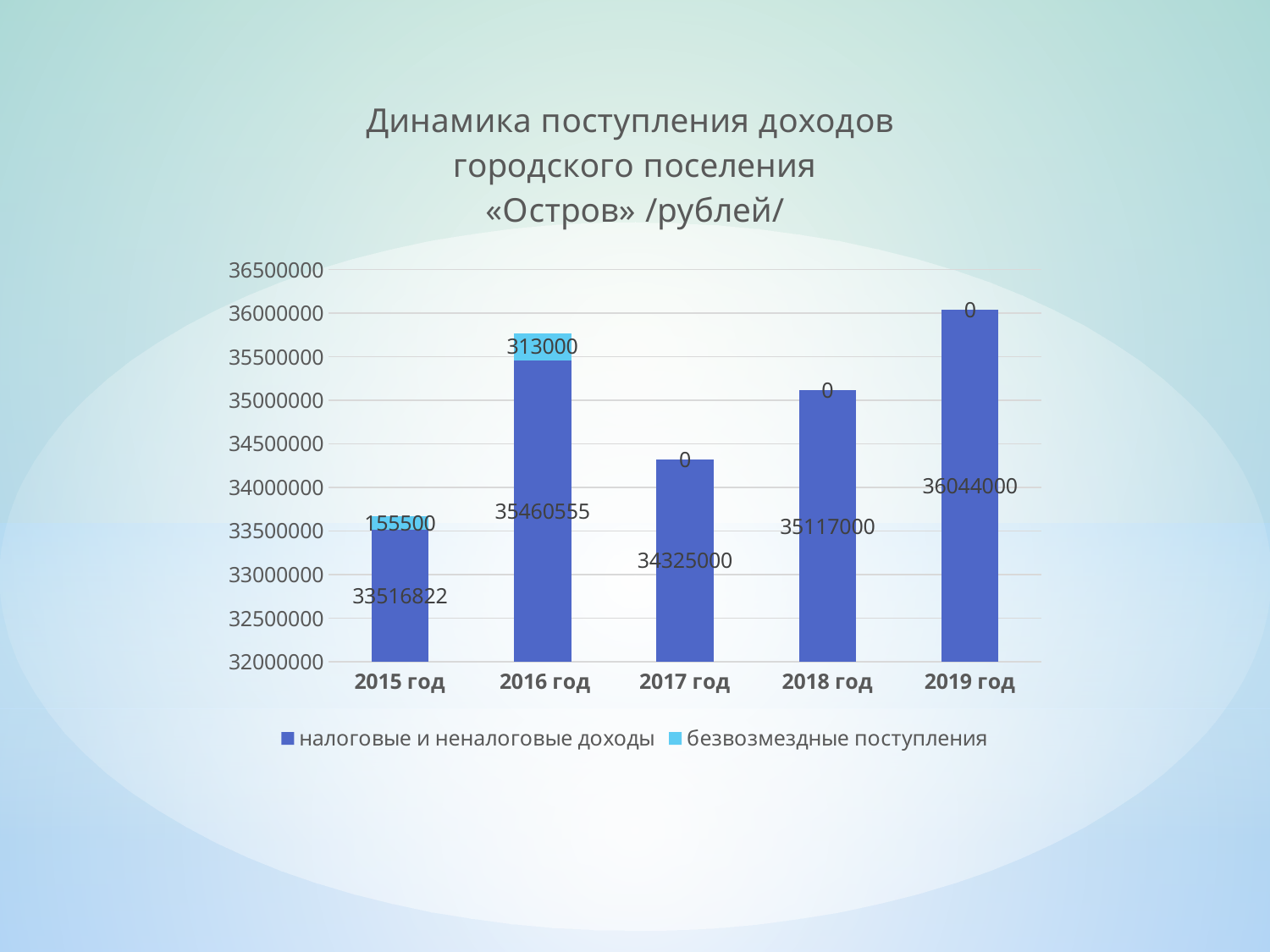
Which is larger: налоговые и неналоговые доходы in 2016 год or in 2017 год? 2016 год What is the total of the stacked bar for 2016 год? 35773555 Which year has the highest value of налоговые и неналоговые доходы? 2019 год How many series does the legend list? 2 What is the value of безвозмездные поступления for 2018 год? 0 What is the difference between налоговые и неналоговые доходы in 2019 год and 2018 год? 927000 Which year has the lowest value of налоговые и неналоговые доходы? 2015 год What kind of chart is shown on the slide? Stacked bar chart What is the value of безвозмездные поступления for 2016 год? 313000 How many years are shown on the x axis? 5 What is the value of налоговые и неналоговые доходы for 2019 год? 36044000 What is the value of налоговые и неналоговые доходы for 2015 год? 33516822